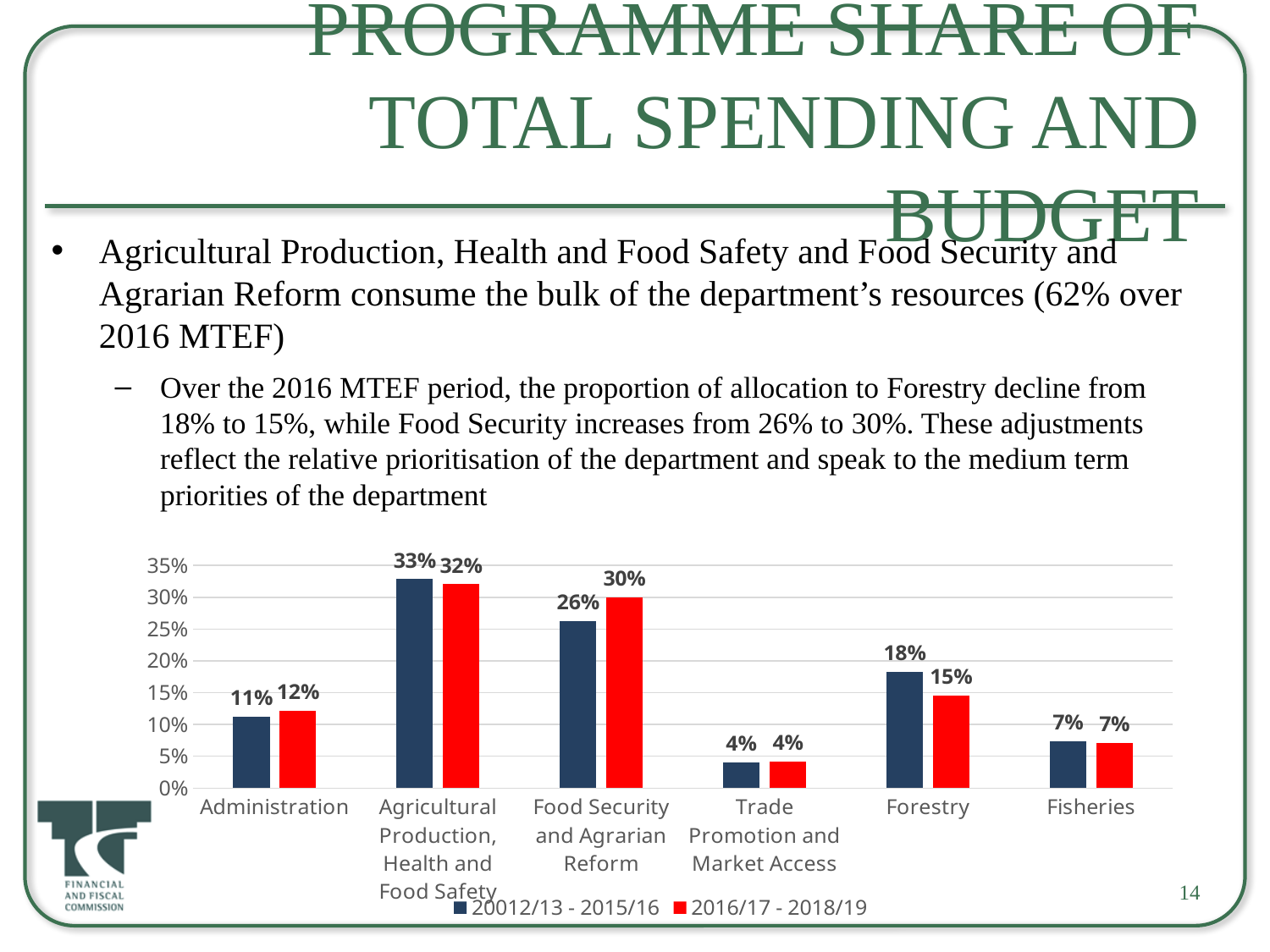
What is the value for Food Security and Agrarian Reform in the 20012/13 - 2015/16 series? 26% What kind of chart is shown on the slide? Bar chart What colour are the bars for the 2016/17 - 2018/19 series? Red How many categories are shown on the x axis of the chart? 6 Which is larger for Agricultural Production, Health and Food Safety: the 20012/13 - 2015/16 value or the 2016/17 - 2018/19 value? 20012/13 - 2015/16 What is the value for Administration in the 2016/17 - 2018/19 series? 12% What is the difference between the 20012/13 - 2015/16 and 2016/17 - 2018/19 values for Food Security and Agrarian Reform? 4% What is the value for Forestry in the 2016/17 - 2018/19 series? 15% How many series does the chart legend list? 2 Which category has the highest value in the 20012/13 - 2015/16 series? Agricultural Production, Health and Food Safety Which category has the lowest value in the 2016/17 - 2018/19 series? Trade Promotion and Market Access What is the difference between the 20012/13 - 2015/16 and 2016/17 - 2018/19 values for Forestry? 3%